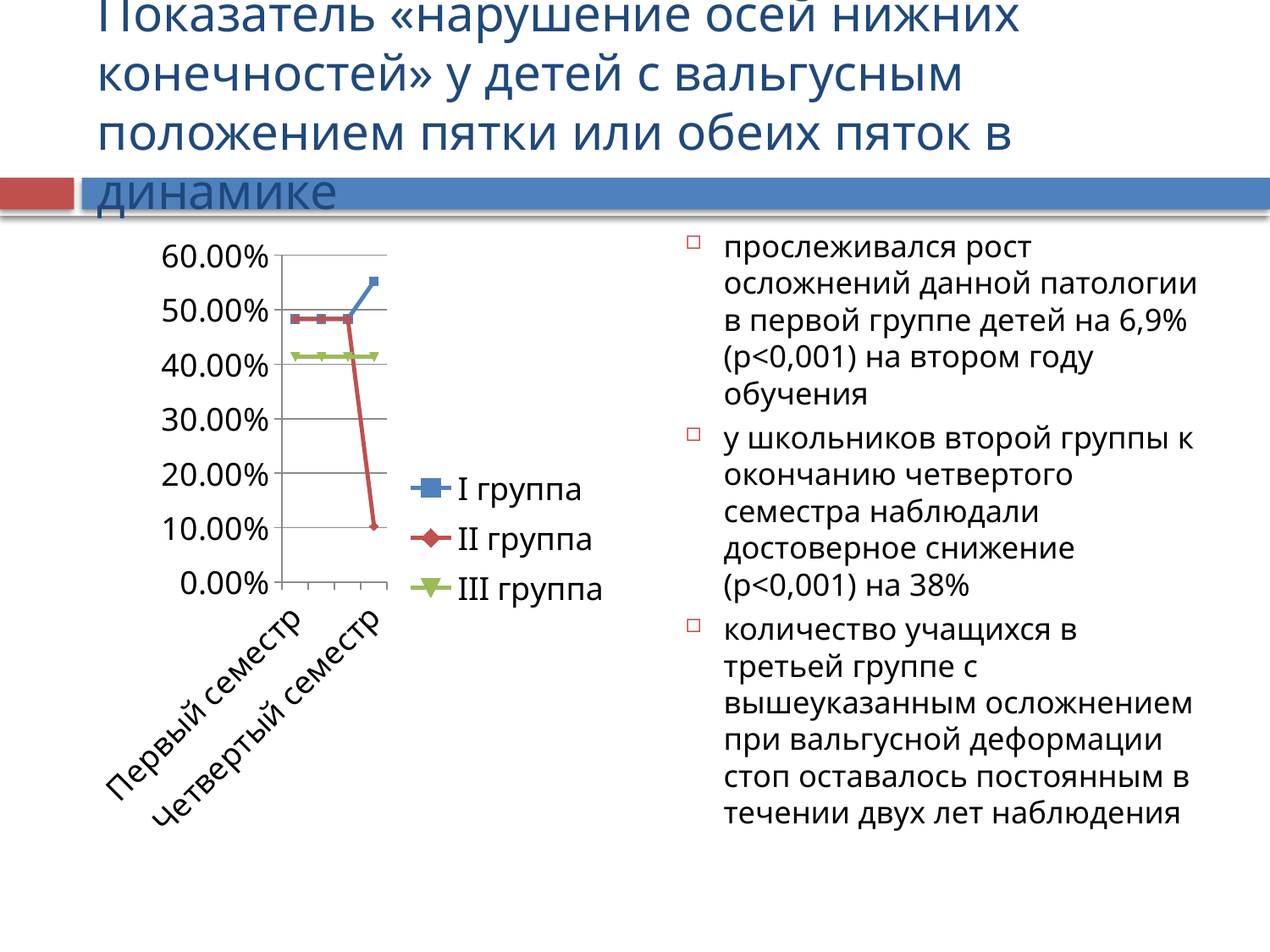
Is the value for II группа at Четвертый семестр greater or less than 20.00%? less How many series does the chart legend list? 3 At Четвертый семестр, which is larger: the value for III группа or the value for II группа? III группа What are the two category labels shown on the x axis of the chart? Первый семестр, Четвертый семестр Which series has the lowest value at Четвертый семестр? II группа Which series are listed in the chart legend? I группа, II группа, III группа Does the value for I группа rise or fall from Первый семестр to Четвертый семестр? rise What kind of chart is shown on the slide? line chart Which series has the highest value at Четвертый семестр? I группа Is the value for I группа at Четвертый семестр greater or less than 50.00%? greater Does the value for II группа rise or fall from Первый семестр to Четвертый семестр? fall Is the value for III группа at Первый семестр greater or less than 40.00%? greater